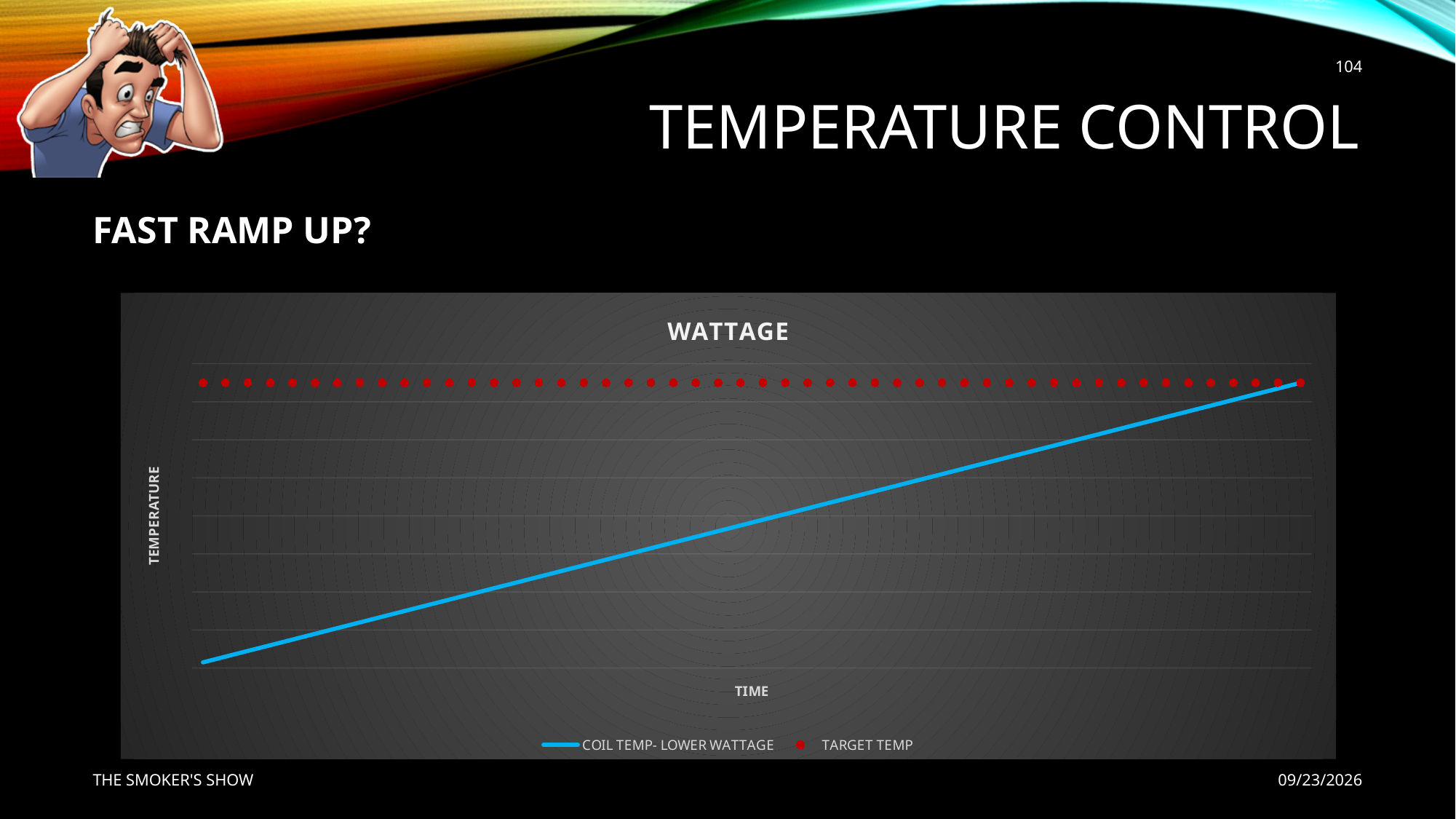
How many series does the chart legend list? 2 Which series is drawn as a solid blue line? COIL TEMP- LOWER WATTAGE What kind of chart is shown on the slide? Line chart What label is on the vertical axis of the chart? TEMPERATURE Does the TARGET TEMP series rise, fall, or stay flat along the time axis? Stays flat What is the title of the chart? WATTAGE At the start of the time axis, which series is higher: COIL TEMP- LOWER WATTAGE or TARGET TEMP? TARGET TEMP Does the COIL TEMP- LOWER WATTAGE line rise or fall along the time axis? Rises